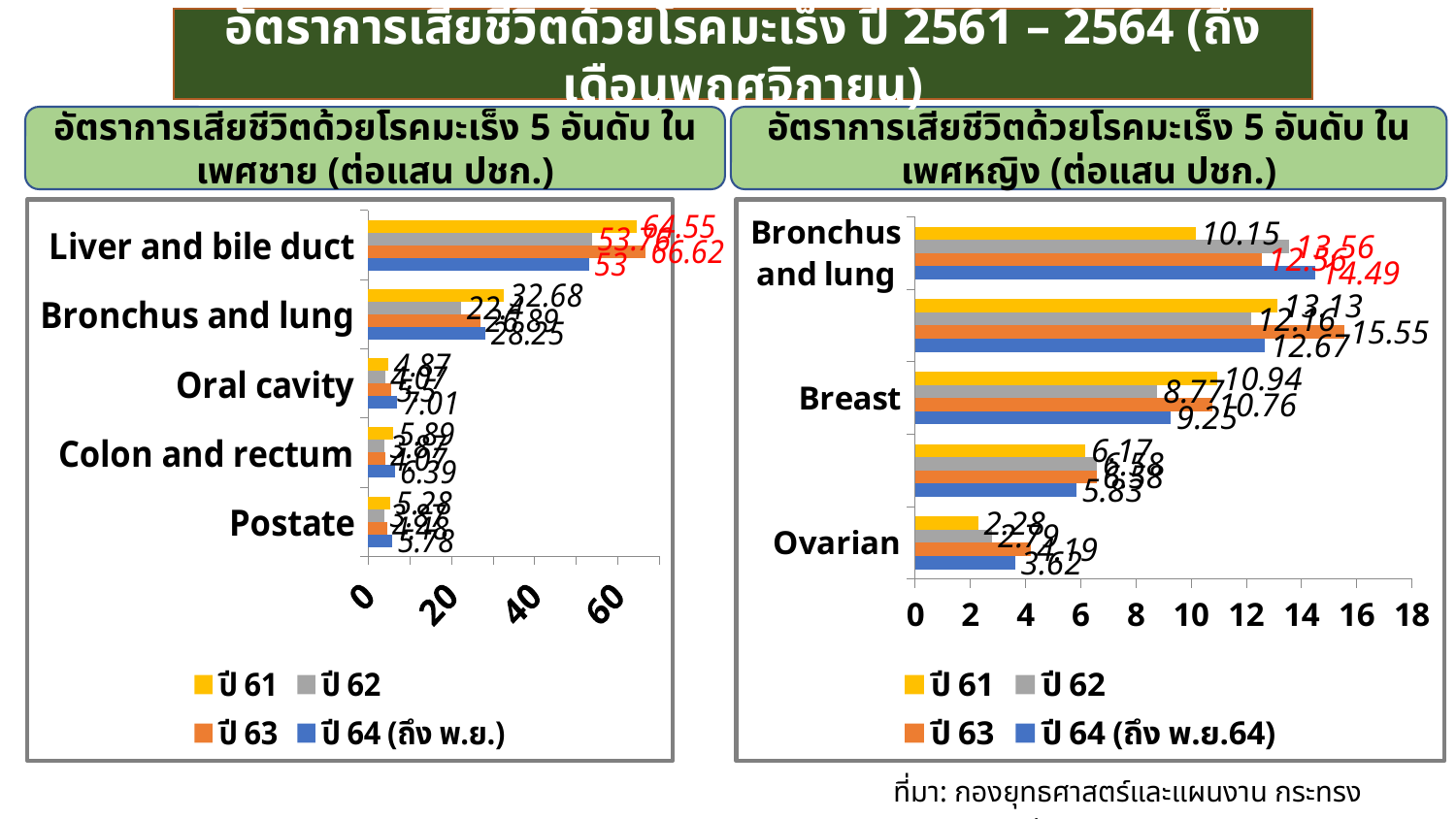
On the left chart (male), which category has the highest value in ปี 61? Liver and bile duct On the right chart (female), which is larger for Breast: ปี 61 or ปี 62? ปี 61 On the left chart (male), what is the value for Bronchus and lung in ปี 64 (ถึง พ.ย.)? 28.25 On the left chart (male), what is the value for Liver and bile duct in ปี 61? 64.55 How many series does the legend of the left chart (male) list? 4 On the right chart (female), what is the difference between the Bronchus and lung values for ปี 64 (ถึง พ.ย.64) and ปี 61? 4.34 What kind of chart is the left chart (male cancer death rates)? bar chart On the right chart (female), what is the value for Breast in ปี 61? 10.94 How many cancer categories are shown on the left chart (male)? 5 On the right chart (female), what is the value for Bronchus and lung in ปี 64 (ถึง พ.ย.64)? 14.49 On the left chart (male), is the value for Bronchus and lung in ปี 61 greater or less than 20? greater On the left chart (male), what is the value for Oral cavity in ปี 64 (ถึง พ.ย.)? 7.01